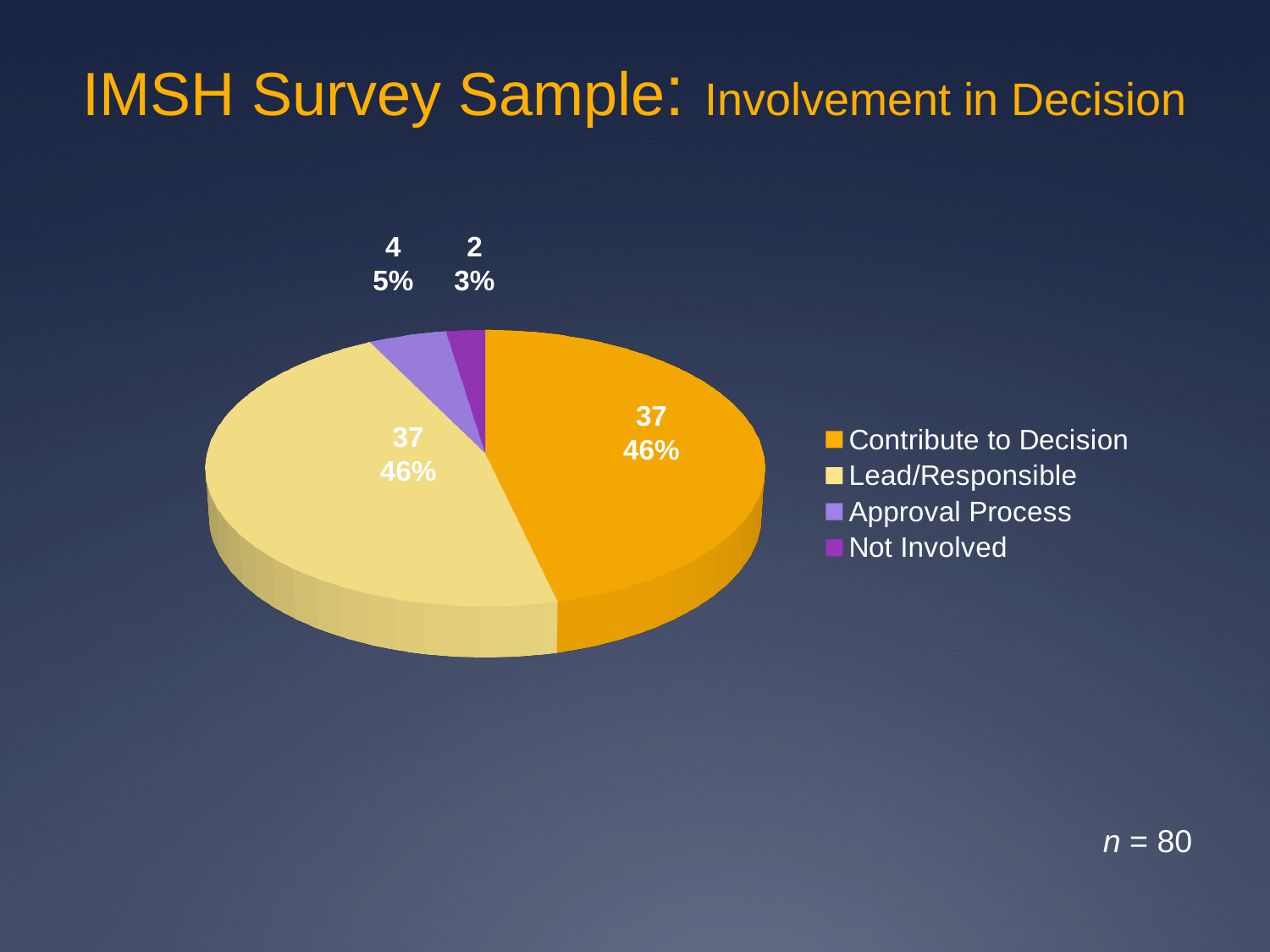
What percentage is shown for the Not Involved slice? 3% Which category has the smallest slice of the pie? Not Involved What is the difference in count between Approval Process and Not Involved? 2 What percentage is shown for the Lead/Responsible slice? 46% What count is shown for the Approval Process slice? 4 What is the sample size (n) stated on the slide? 80 What count is shown for the Contribute to Decision slice? 37 What share of the pie does the Approval Process slice represent? 5% What kind of chart is shown on the slide? Pie chart Which is larger, the Approval Process slice or the Not Involved slice? Approval Process What is the difference in count between Contribute to Decision and Approval Process? 33 How many categories does the pie chart show? 4